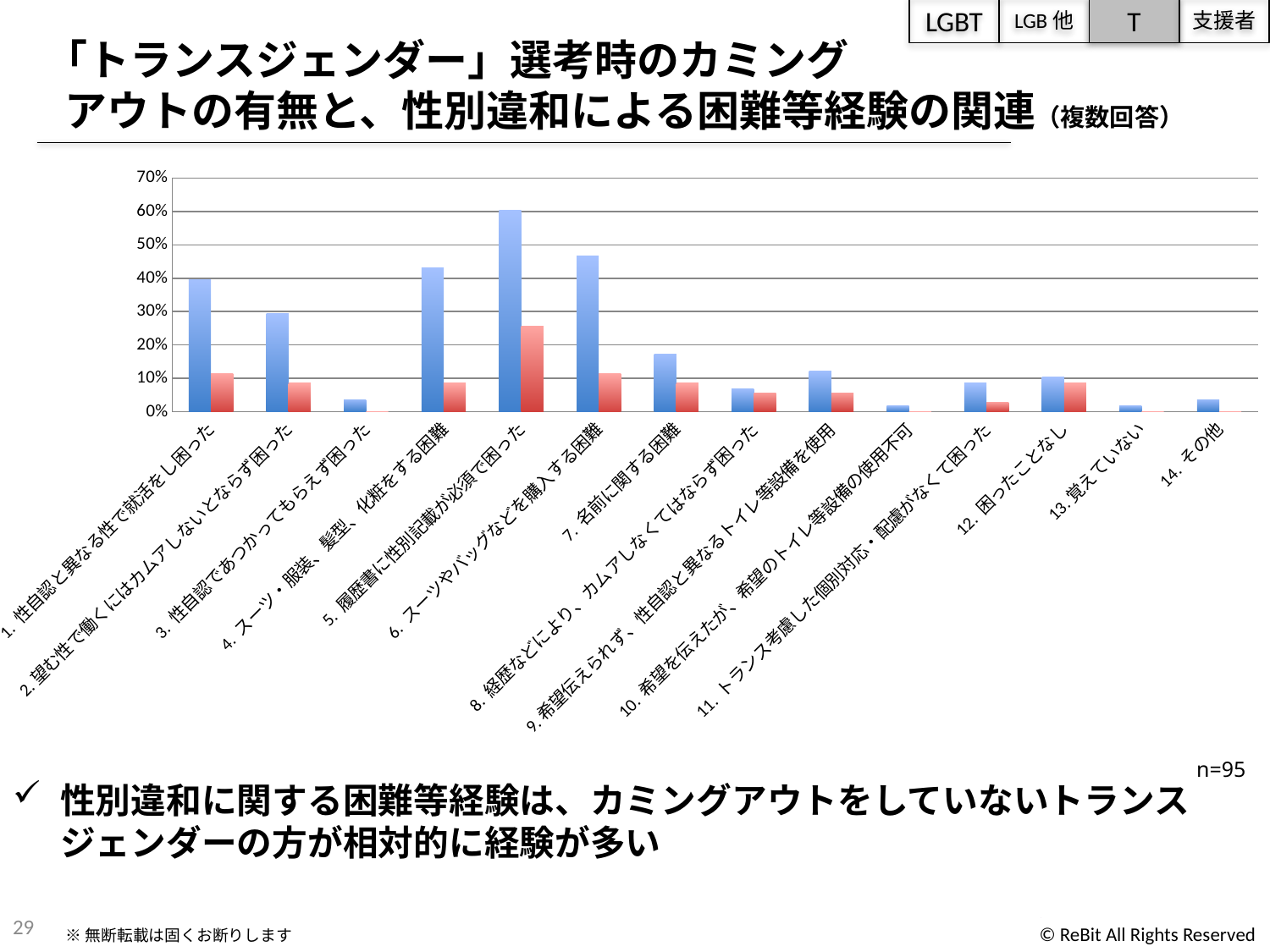
In category 5 (履歴書に性別記載が必須で困った), which bar is taller, the blue one or the red one? the blue one Which is larger: the blue bar for category 5 or the blue bar for category 6? category 5 Which category has the tallest blue bar? 5. 履歴書に性別記載が必須で困った What sample size (n) is stated on the slide for the chart? n=95 What kind of chart is shown on the slide? bar chart Is the blue bar for category 4 (スーツ・服装、髪型、化粧をする困難) greater or less than 10%? greater Is the red bar for category 5 (履歴書に性別記載が必須で困った) greater or less than 20%? greater How many categories are shown along the x axis of the chart? 14 Which category has the tallest red bar? 5. 履歴書に性別記載が必須で困った Is the blue bar for category 5 (履歴書に性別記載が必須で困った) greater or less than 50%? greater